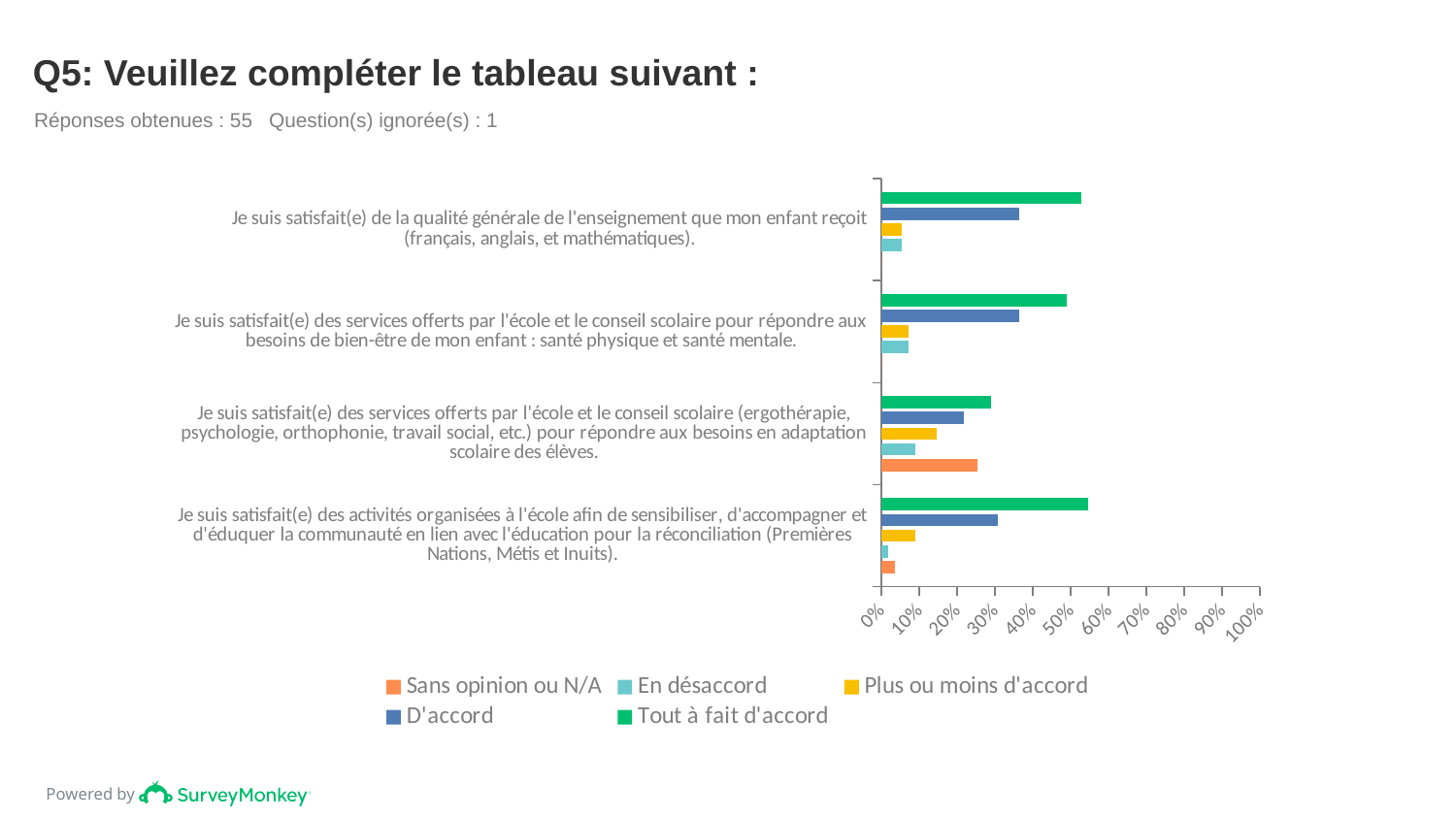
What kind of chart is shown on the slide? bar chart How many statements (categories) are plotted on the chart? 4 For the statement about activities for reconciliation, which is larger: 'D'accord' or 'Plus ou moins d'accord'? D'accord Is the 'Tout à fait d'accord' value for the statement about services for adaptation scolaire greater or less than 40%? less What colour represents 'Tout à fait d'accord' in the legend? green How many series does the legend list? 5 Is the 'D'accord' value for the statement about activities for reconciliation (Premières Nations, Métis et Inuits) greater or less than 20%? greater For the statement about the general quality of teaching, which is larger: 'Tout à fait d'accord' or 'D'accord'? Tout à fait d'accord Is the 'En désaccord' value for the statement about activities for reconciliation greater or less than 10%? less Which statement has the lowest 'Tout à fait d'accord' value? Je suis satisfait(e) des services offerts par l'école et le conseil scolaire (ergothérapie, psychologie, orthophonie, travail social, etc.) pour répondre aux besoins en adaptation scolaire des élèves.